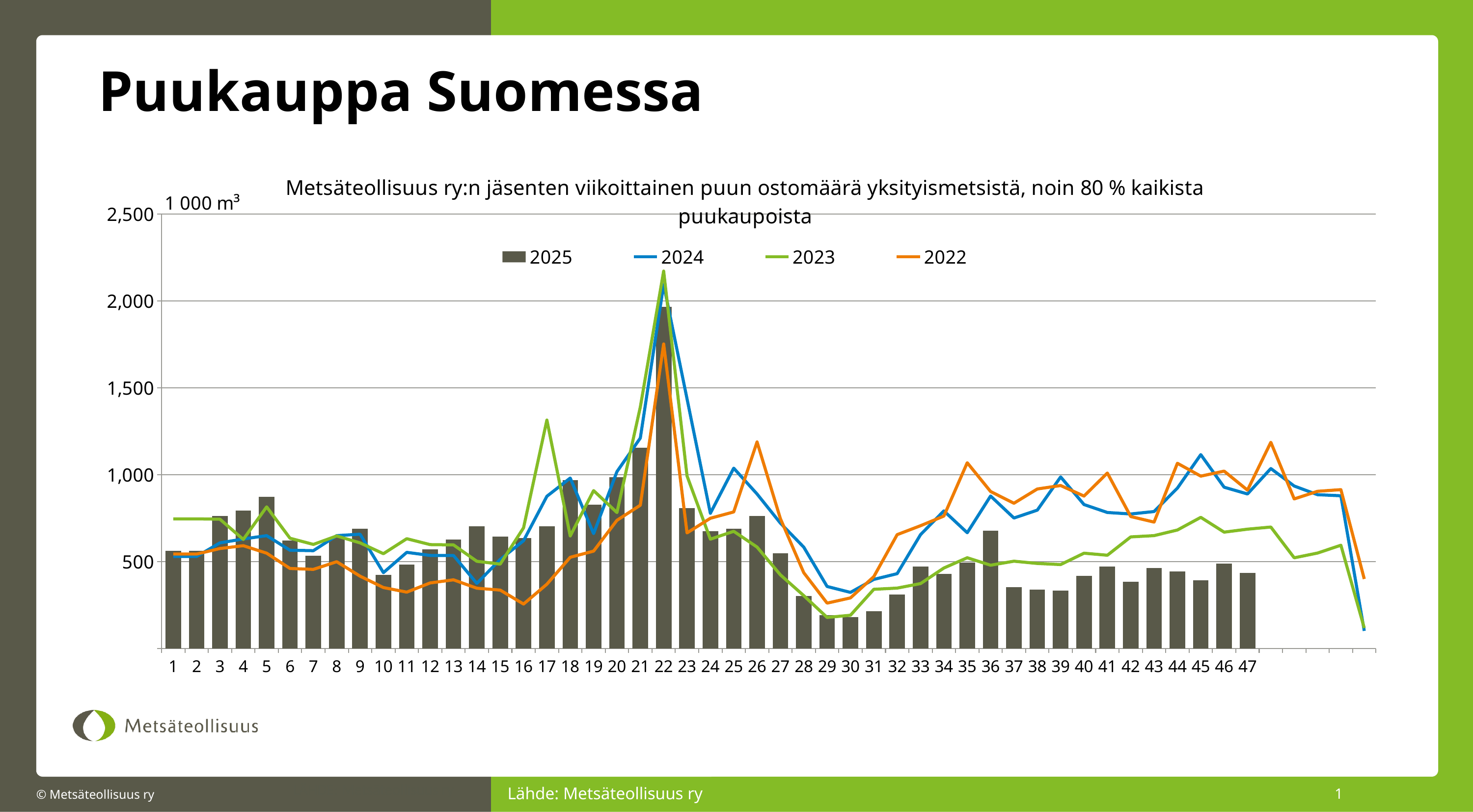
Is the 2025 bar for week 5 greater or less than 500? greater Do the 2025 bars rise or fall from week 22 to week 30? fall In which week is the 2025 bar the highest? Week 22 How many weeks have a 2025 bar plotted in the chart? 47 Is the 2025 bar for week 29 greater or less than 500? less Is the 2022 line value for week 26 greater or less than 1,000? greater Which is larger, the 2025 bar for week 21 or the 2025 bar for week 22? Week 22 What unit is shown on the vertical axis of the chart? 1 000 m³ How many series does the chart legend list? 4 Which series is drawn in orange in the chart? 2022 What kind of chart is shown on the slide? A combined bar and line chart